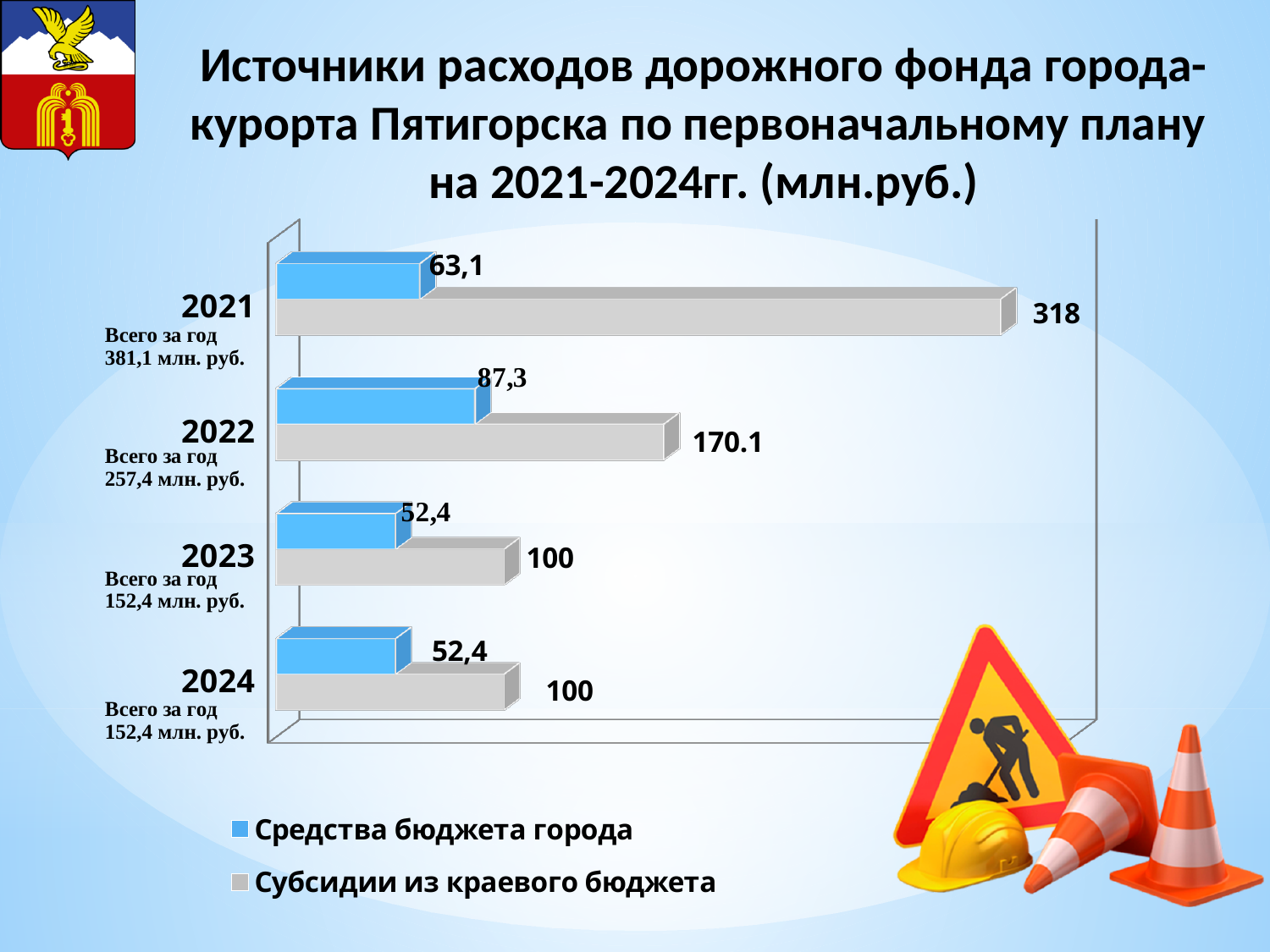
How many years are shown on the chart? 4 What is the value of Средства бюджета города for 2022? 87,3 What colour represents Средства бюджета города in the chart? Blue Which year has the highest value for Субсидии из краевого бюджета? 2021 What is the value of Субсидии из краевого бюджета for 2021? 318 How many series does the legend list? 2 Which is larger for 2022: Средства бюджета города or Субсидии из краевого бюджета? Субсидии из краевого бюджета Which year has the highest value for Средства бюджета города? 2022 What is the difference between Субсидии из краевого бюджета for 2021 and 2022? 147.9 What is the value of Субсидии из краевого бюджета for 2022? 170.1 What is the value of Средства бюджета города for 2021? 63,1 What kind of chart is shown on the slide? Bar chart